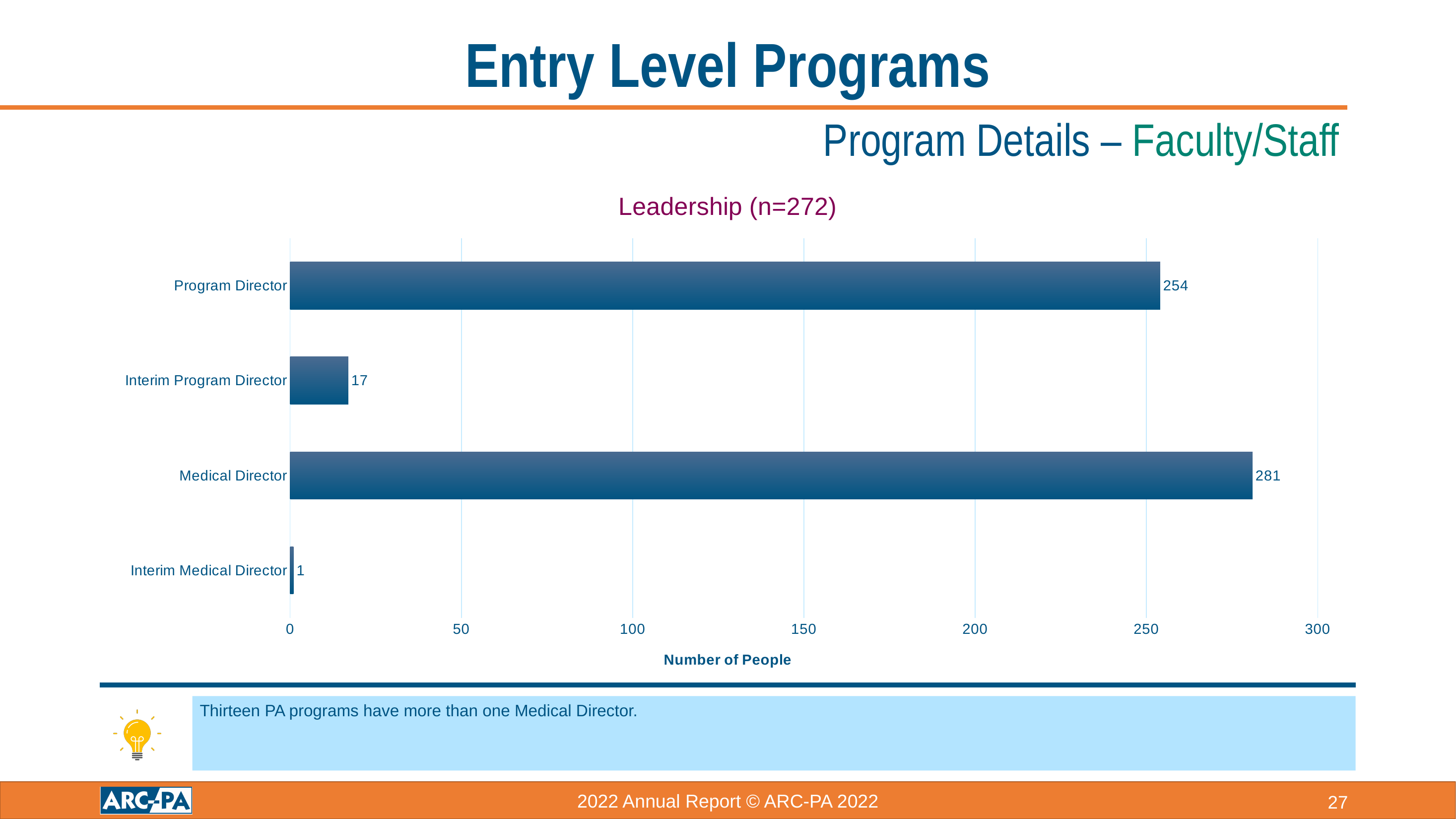
What kind of chart is shown on the slide? Bar chart Which category has the lowest number of people? Interim Medical Director What is the title of the chart? Leadership (n=272) Which is larger, the value for Program Director or the value for Interim Program Director? Program Director What is the number of people for Interim Medical Director? 1 What is the difference between the number of Medical Directors and Program Directors? 27 How many categories are shown in the chart? 4 What is the number of people for Interim Program Director? 17 What is the number of people for Medical Director? 281 Which category has the highest number of people? Medical Director What is the number of people for Program Director? 254 Is the value for Program Director greater or less than 250? greater